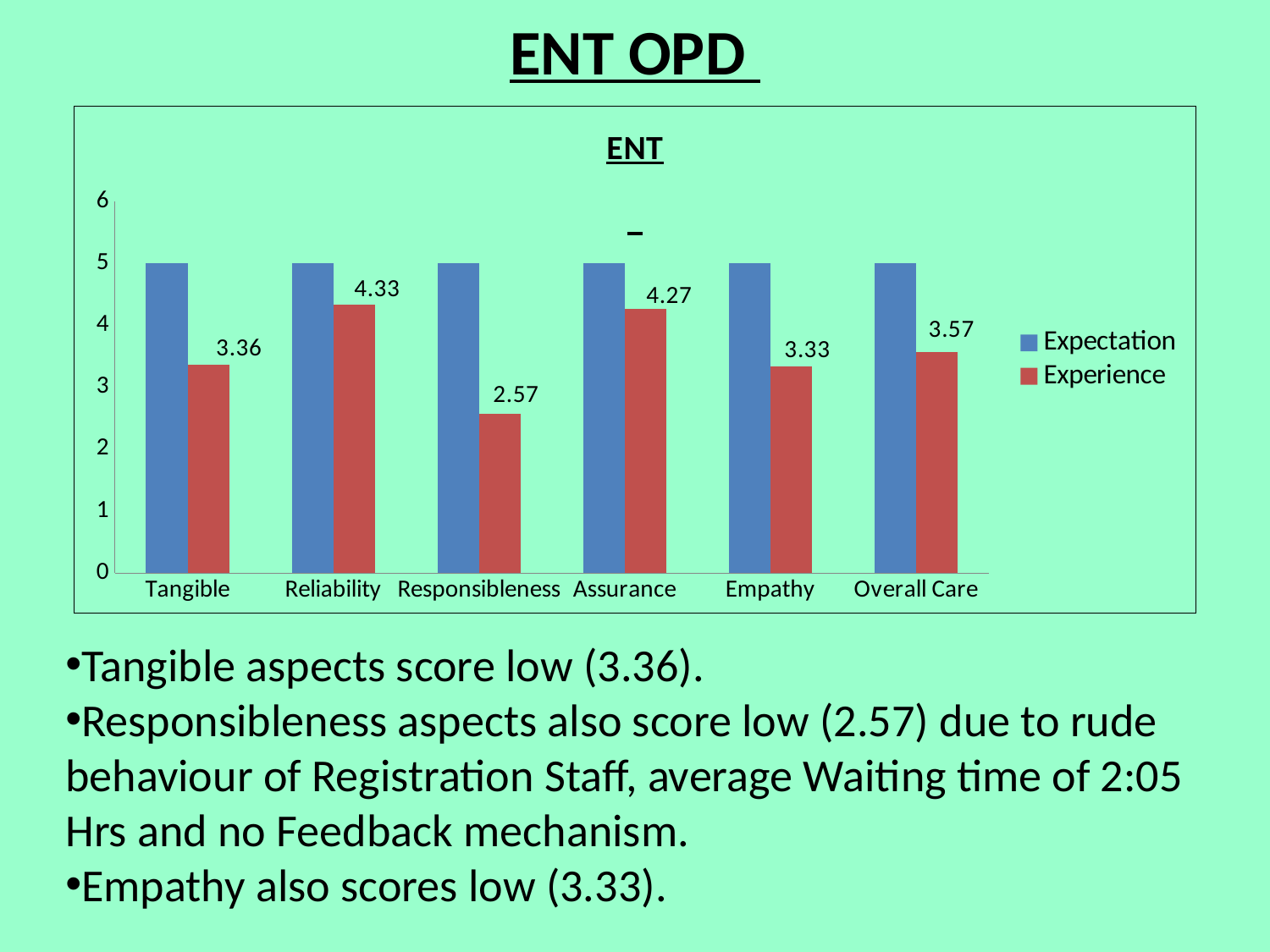
What is the difference between the Experience values for Reliability and Responsibleness? 1.76 Which has a larger Experience value, Assurance or Overall Care? Assurance How many categories are shown on the x axis? 6 What is the Experience value for Reliability? 4.33 What is the Experience value for Responsibleness? 2.57 What kind of chart is shown? bar chart What is the Expectation value for Tangible? 5 What is the Experience value for Overall Care? 3.57 Which category has the highest Experience value? Reliability How many series does the legend list? 2 Is the Expectation value for Empathy greater or less than 4? greater Which category has the lowest Experience value? Responsibleness